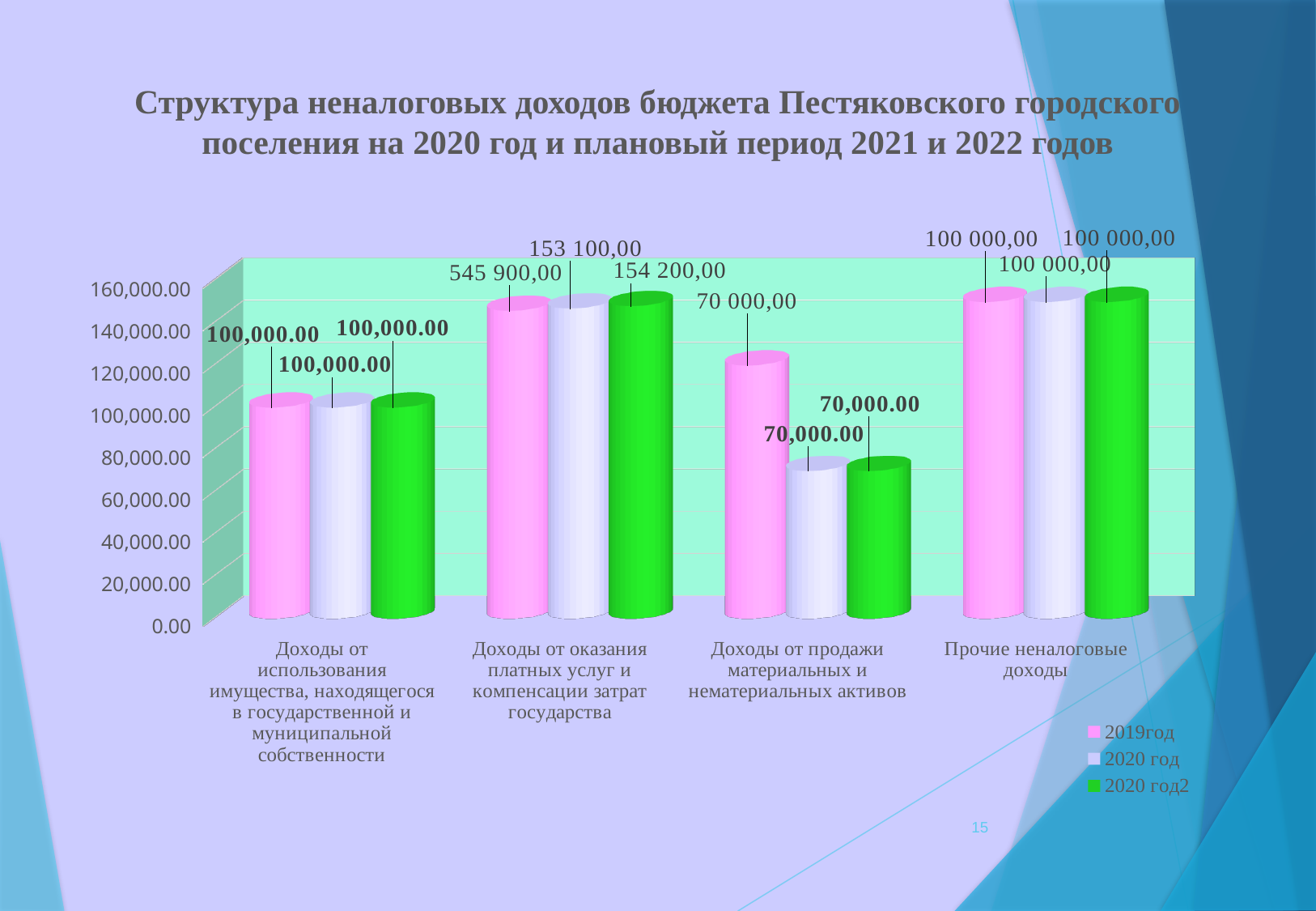
Which category has the lowest value for the 2020 год series? Доходы от продажи материальных и нематериальных активов Is the 2020 год2 value for 'Доходы от продажи материальных и нематериальных активов' greater or less than 100,000.00? less What is the value for 2020 год2 in the category 'Доходы от оказания платных услуг и компенсации затрат государства'? 154 200,00 What is the value for 2020 год in the category 'Доходы от оказания платных услуг и компенсации затрат государства'? 153 100,00 What is the value for 2019год in the category 'Доходы от использования имущества, находящегося в государственной и муниципальной собственности'? 100,000.00 What kind of chart is shown on the slide? bar chart How many categories are shown on the x axis of the chart? 4 Which series is shown in green in the chart legend? 2020 год2 How many series does the chart legend list? 3 What is the value for 2020 год2 in the category 'Прочие неналоговые доходы'? 100 000,00 What is the value for 2019год in the category 'Доходы от продажи материальных и нематериальных активов'? 70 000,00 What is the difference between the 2020 год2 and 2020 год values in the category 'Доходы от оказания платных услуг и компенсации затрат государства'? 1 100,00